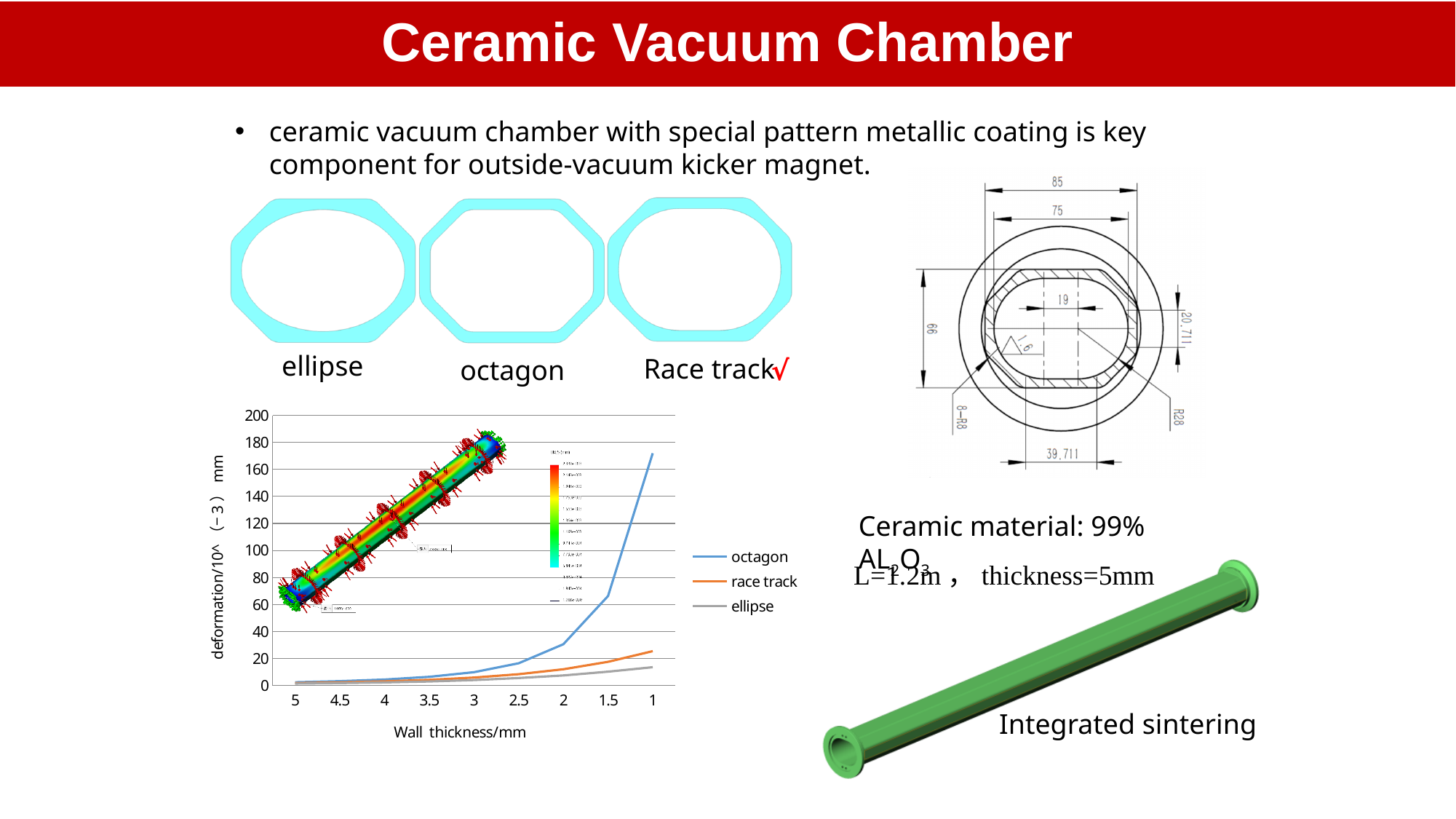
Which series are listed in the chart legend? octagon, race track, ellipse How many series does the chart legend list? 3 Which series has the lowest deformation at a wall thickness of 1 mm? ellipse Which series has the highest deformation at a wall thickness of 1 mm? octagon What is the label of the x axis of the chart? Wall thickness/mm Is the deformation for ellipse at a wall thickness of 1 mm greater or less than 20? less Is the deformation for octagon at a wall thickness of 1 mm greater or less than 160? greater At a wall thickness of 1 mm, which series has the larger deformation, octagon or race track? octagon Does the deformation for octagon rise or fall as you move from left to right along the x axis (from 5 mm to 1 mm wall thickness)? rise What kind of chart is shown on the slide? line chart Is the deformation for race track at a wall thickness of 1 mm greater or less than 40? less How many wall thickness values are marked on the x axis of the chart? 9